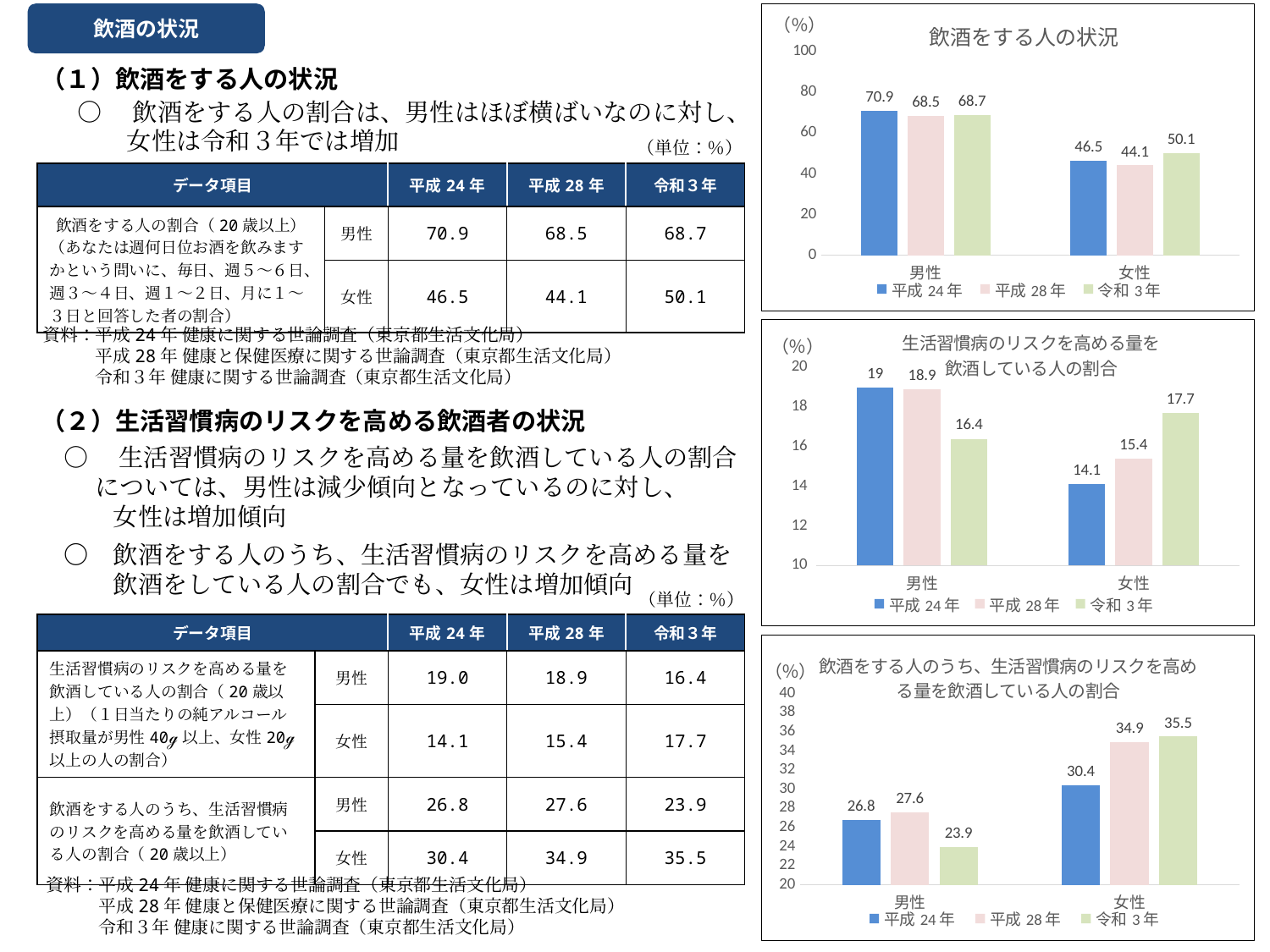
In the chart titled 飲酒をする人のうち、生活習慣病のリスクを高める量を飲酒している人の割合, what is the value for 男性 in 令和3年? 23.9 What kind of chart is the chart titled 飲酒をする人の状況? bar chart In the chart titled 生活習慣病のリスクを高める量を飲酒している人の割合, which is larger for 令和3年: 男性 or 女性? 女性 In the chart titled 生活習慣病のリスクを高める量を飲酒している人の割合, do the 女性 values rise or fall from 平成24年 to 令和3年? rise In the chart titled 飲酒をする人のうち、生活習慣病のリスクを高める量を飲酒している人の割合, which bar has the highest value? 女性 令和3年 (35.5) In the chart titled 飲酒をする人の状況, how many series does the legend list? 3 In the chart titled 生活習慣病のリスクを高める量を飲酒している人の割合, what is the value for 男性 in 平成24年? 19 In the chart titled 飲酒をする人の状況, what is the difference between the 男性 and 女性 values for 平成28年? 24.4 In the chart titled 生活習慣病のリスクを高める量を飲酒している人の割合, what is the value for 女性 in 平成28年? 15.4 In the chart titled 飲酒をする人のうち、生活習慣病のリスクを高める量を飲酒している人の割合, what is the difference between the 女性 values for 平成28年 and 平成24年? 4.5 In the chart titled 飲酒をする人の状況, what is the value for 男性 in 平成24年? 70.9 In the chart titled 飲酒をする人の状況, what is the value for 女性 in 令和3年? 50.1